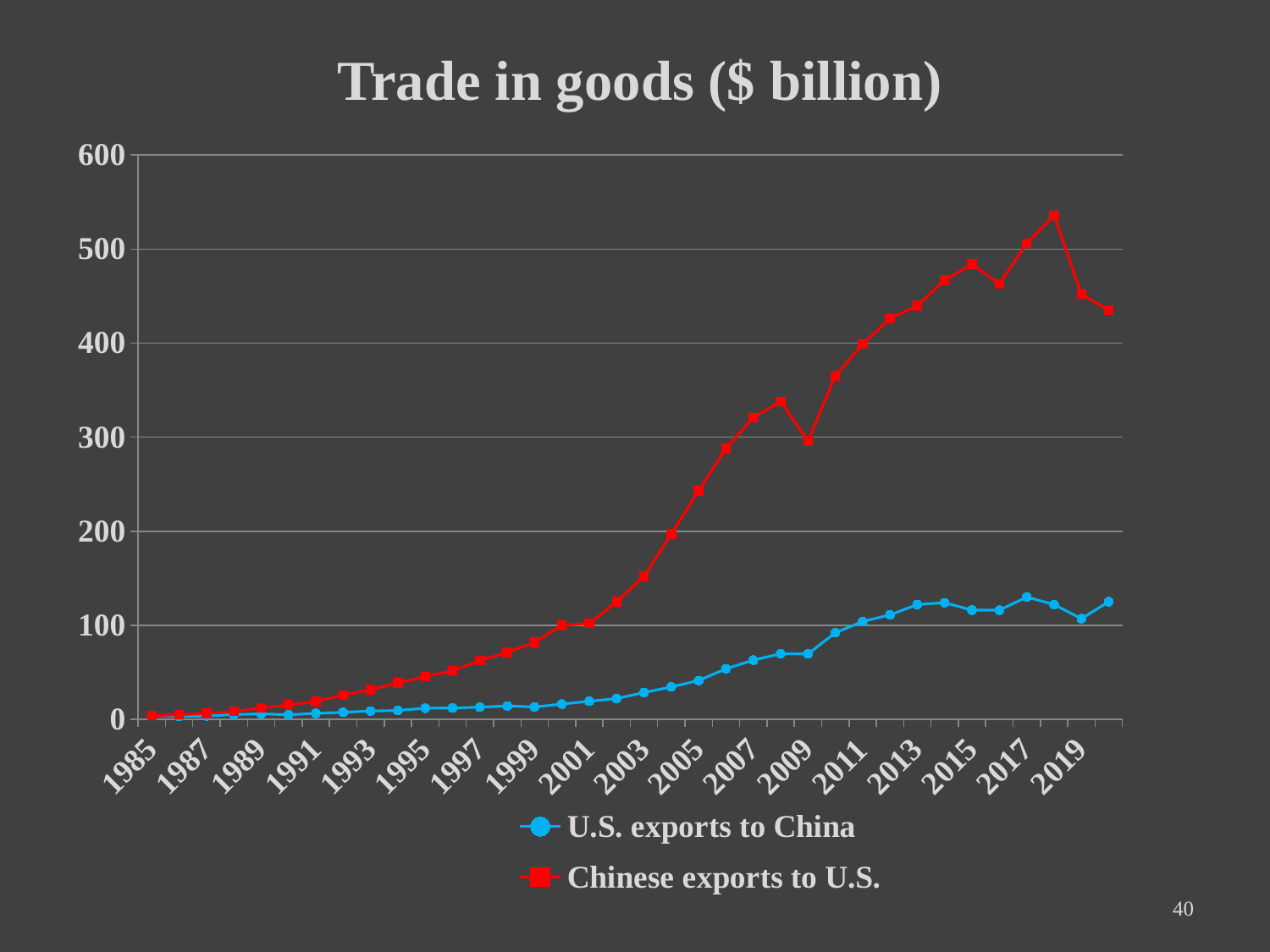
Is the value for Chinese exports to U.S. in 2018 greater or less than 500? greater In which year are Chinese exports to U.S. at their lowest? 1985 Is the value for U.S. exports to China in 2005 greater or less than 100? less In which year do Chinese exports to U.S. reach their highest value? 2018 Is the value for Chinese exports to U.S. in 2015 greater or less than 500? less In 2018, which is larger: U.S. exports to China or Chinese exports to U.S.? Chinese exports to U.S. What is the title of the chart? Trade in goods ($ billion) How many series does the legend list? 2 Which series is drawn in red? Chinese exports to U.S. What kind of chart is shown on the slide? line chart Do Chinese exports to U.S. rise or fall from 2018 to 2020? fall